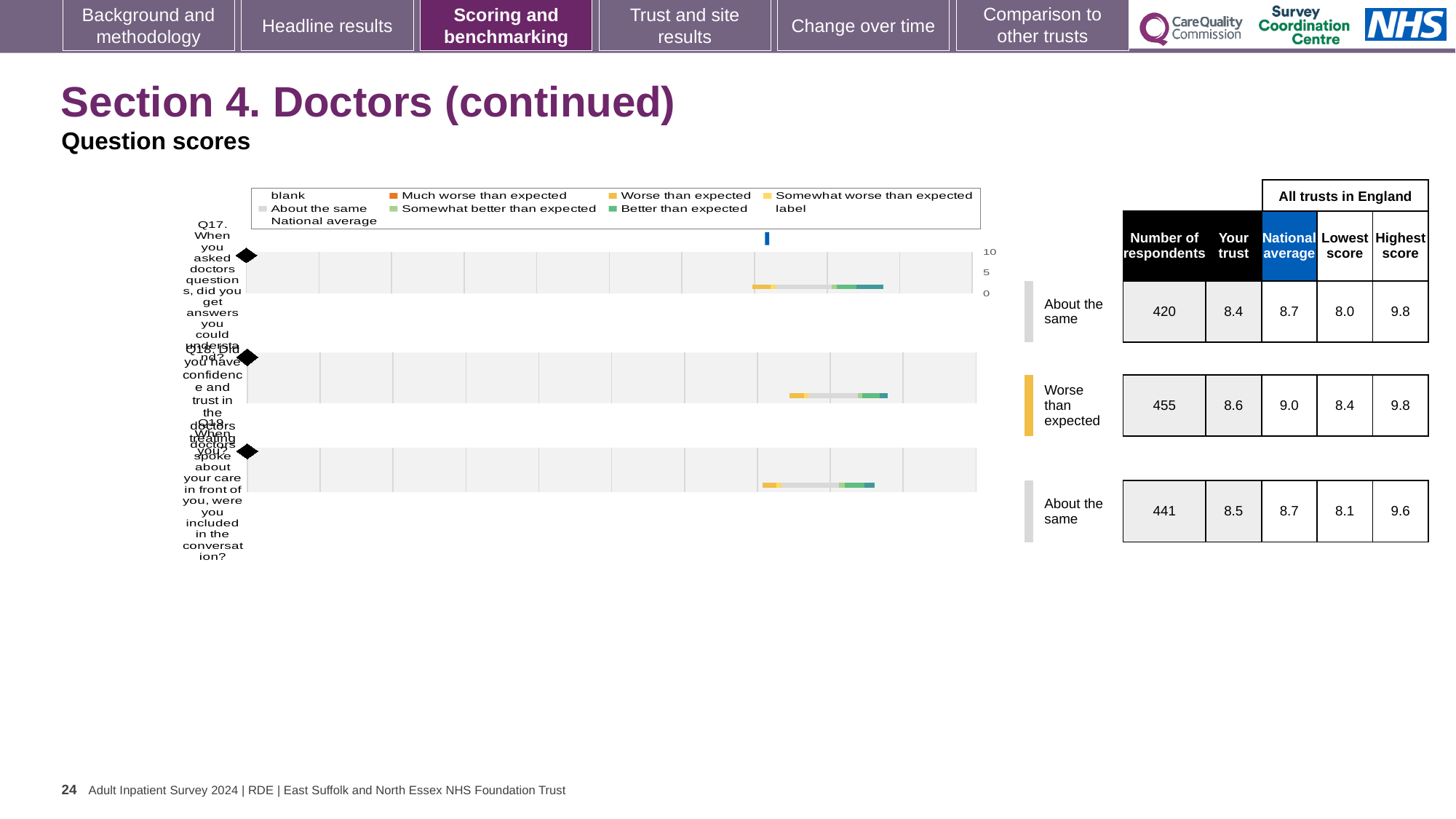
What benchmark category is shown for Q18? Worse than expected How many respondents answered Q19 (When doctors spoke about your care in front of you, were you included in the conversation?)? 441 Which has the higher 'Your trust' score, Q17 or Q19? Q19 What kind of chart is used to show the question scores on this slide? bar chart What is the lowest score among all trusts in England for Q17? 8.0 What is the highest score among all trusts in England for Q19? 9.6 What is the national average score for Q18 (Did you have confidence and trust in the doctors treating you?)? 9.0 Which question has the highest 'Your trust' score? Q18 How many questions (Q17, Q18, Q19) are plotted in the question scores chart? 3 Which question has the lowest number of respondents? Q17 What is the difference between the national average and the 'Your trust' score for Q18? 0.4 What is the 'Your trust' score for Q17 (When you asked doctors questions, did you get answers you could understand?)? 8.4